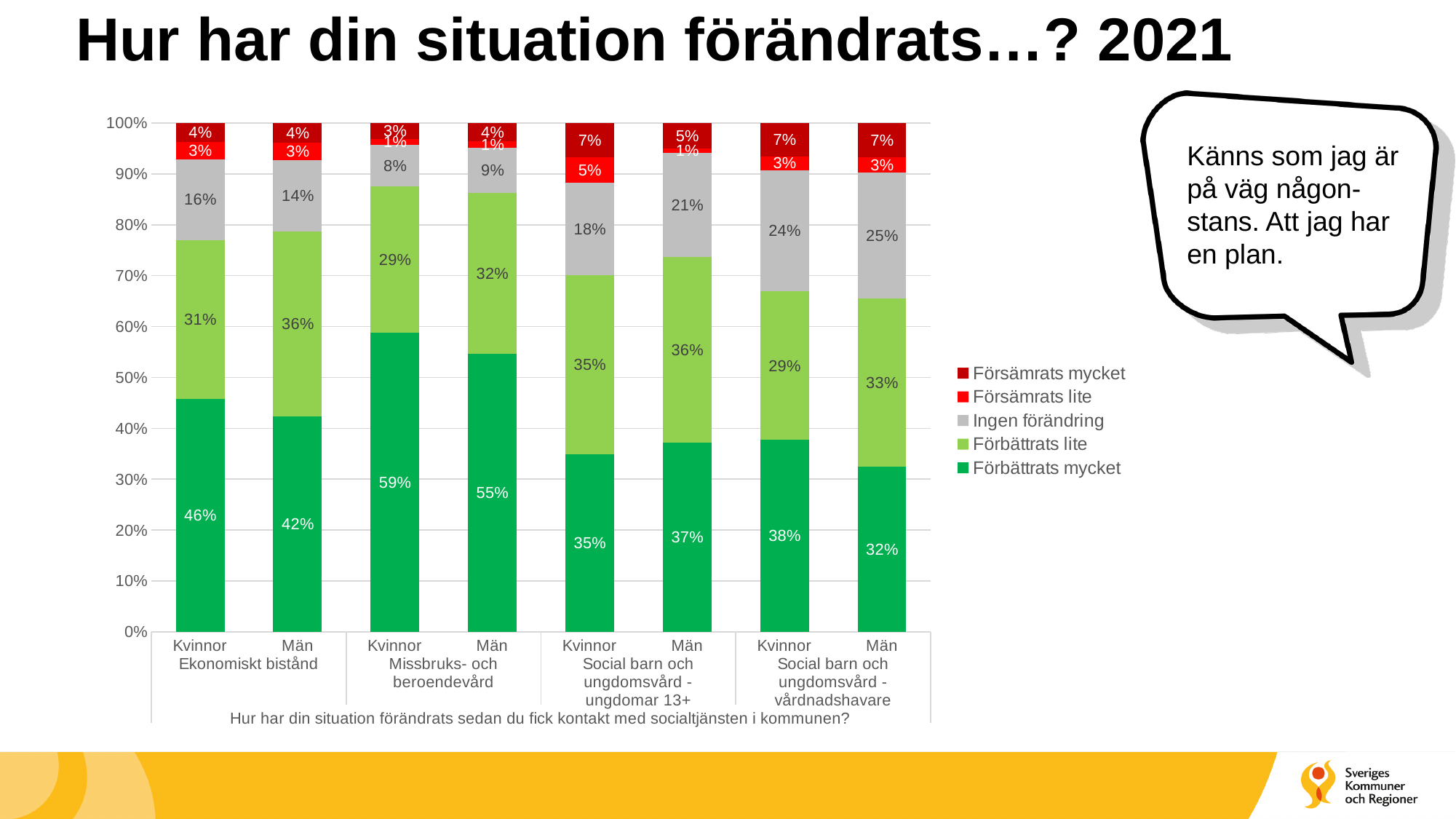
How many series does the legend list? 5 What is the difference in Förbättrats mycket between Kvinnor and Män in Ekonomiskt bistånd? 4 percentage points What kind of chart is shown on the slide? Stacked bar chart What is the value of Förbättrats lite for Män in Ekonomiskt bistånd? 36% Which bar has the highest value for Förbättrats mycket? Kvinnor, Missbruks- och beroendevård What is the value of Förbättrats mycket for Kvinnor in Missbruks- och beroendevård? 59% Which is larger: Ingen förändring for Kvinnor in Social barn och ungdomsvård - ungdomar 13+ or for Män in the same group? Män Which colour represents Ingen förändring in the legend? Grey How many bars are plotted in the chart? 8 What is the value of Försämrats mycket for Kvinnor in Social barn och ungdomsvård - ungdomar 13+? 7% Which bar has the lowest value for Förbättrats mycket? Män, Social barn och ungdomsvård - vårdnadshavare What is the value of Ingen förändring for Män in Social barn och ungdomsvård - vårdnadshavare? 25%